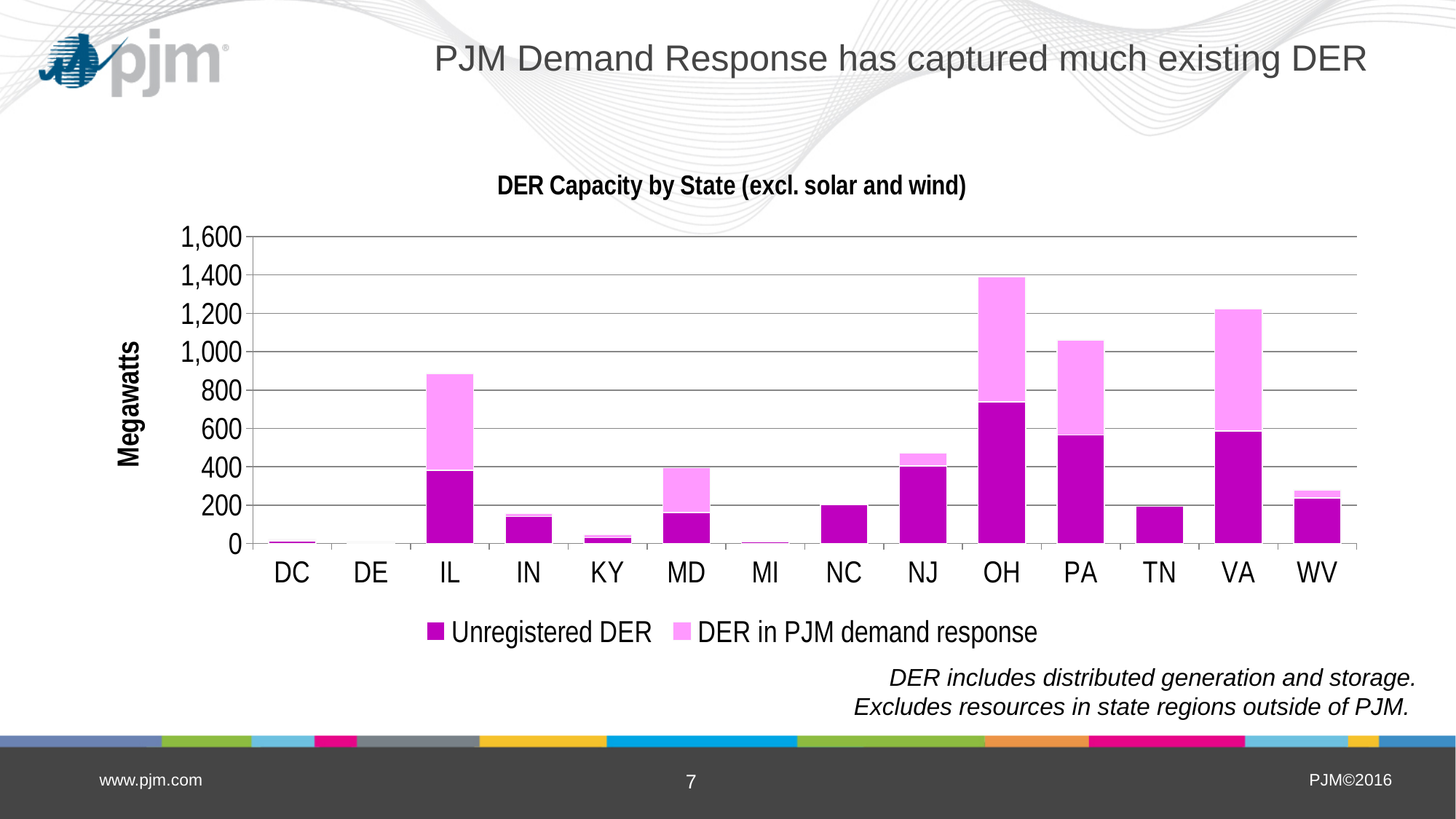
What is the label of the y axis? Megawatts Is the Unregistered DER value for PA greater or less than 400 megawatts? greater How many series does the legend list? 2 Which state has the larger total DER capacity, VA or PA? VA Which state has the highest total DER capacity? OH Is the total DER capacity for MD greater or less than 600 megawatts? less Is the total DER capacity for NC greater or less than 400 megawatts? less What kind of chart is shown on the slide? Stacked bar chart How many states are shown on the x axis? 14 What is the title of the chart? DER Capacity by State (excl. solar and wind)